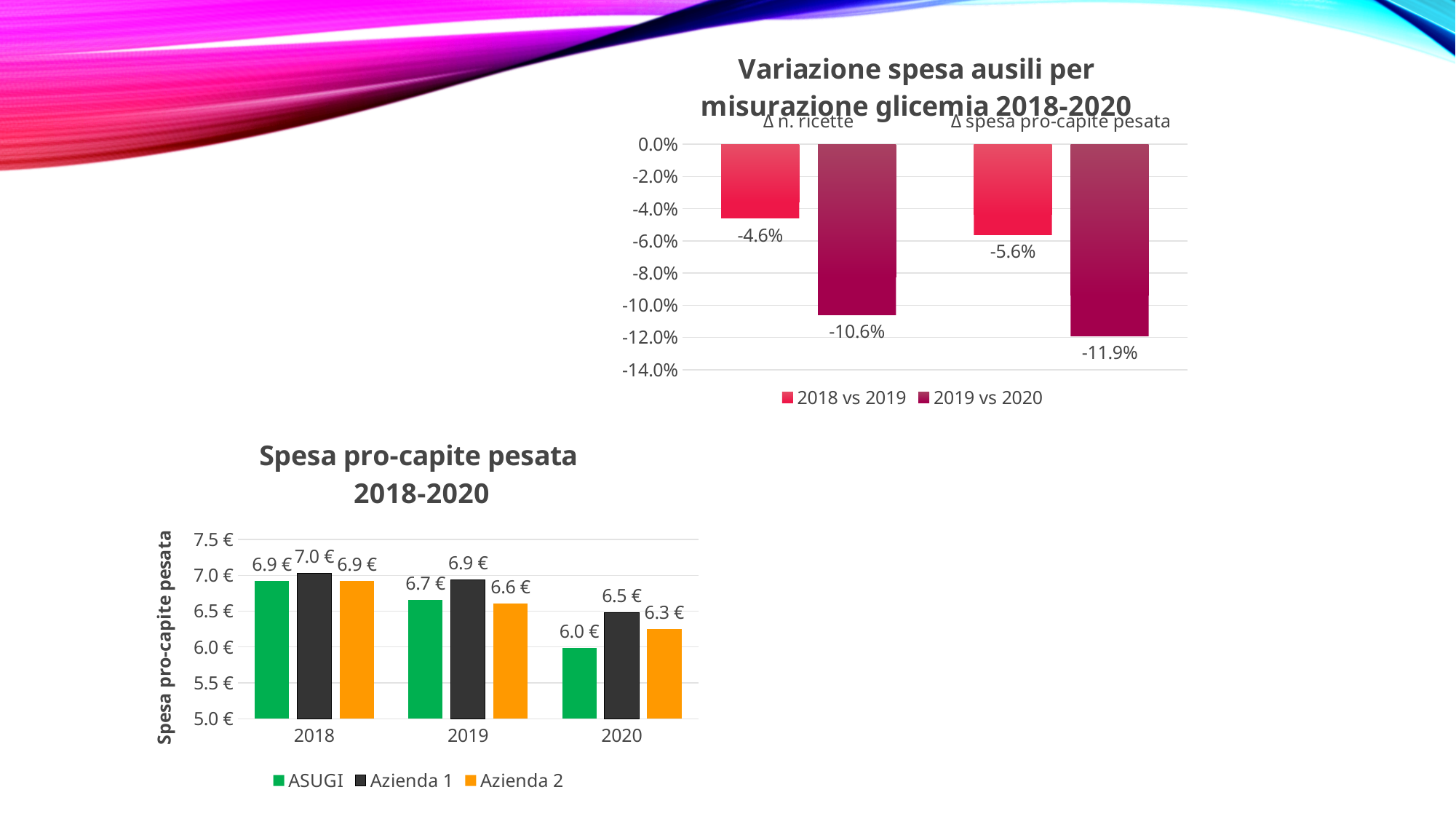
In the chart 'Spesa pro-capite pesata 2018-2020', do the ASUGI values rise or fall from 2018 to 2020? Fall In the chart 'Variazione spesa ausili per misurazione glicemia 2018-2020', what is the difference between the '2019 vs 2020' and '2018 vs 2019' values for 'Δ n. ricette'? 6.0 percentage points In the chart 'Spesa pro-capite pesata 2018-2020', what is the value for ASUGI in 2020? 6.0 € In the chart 'Variazione spesa ausili per misurazione glicemia 2018-2020', what is the value for 'Δ spesa pro-capite pesata' in the '2019 vs 2020' series? -11.9% In the chart 'Spesa pro-capite pesata 2018-2020', how many years are shown on the x axis? 3 In the chart 'Variazione spesa ausili per misurazione glicemia 2018-2020', how many series does the legend list? 2 In the chart 'Spesa pro-capite pesata 2018-2020', is the value for Azienda 2 in 2020 larger or smaller than the value for ASUGI in 2020? Larger In the chart 'Spesa pro-capite pesata 2018-2020', what is the value for Azienda 1 in 2018? 7.0 € What kind of chart is 'Spesa pro-capite pesata 2018-2020'? Bar chart In the chart 'Variazione spesa ausili per misurazione glicemia 2018-2020', what is the value for 'Δ n. ricette' in the '2018 vs 2019' series? -4.6% In the chart 'Variazione spesa ausili per misurazione glicemia 2018-2020', which category has the lowest value in the '2019 vs 2020' series? Δ spesa pro-capite pesata In the chart 'Spesa pro-capite pesata 2018-2020', which series has the highest value in 2020? Azienda 1